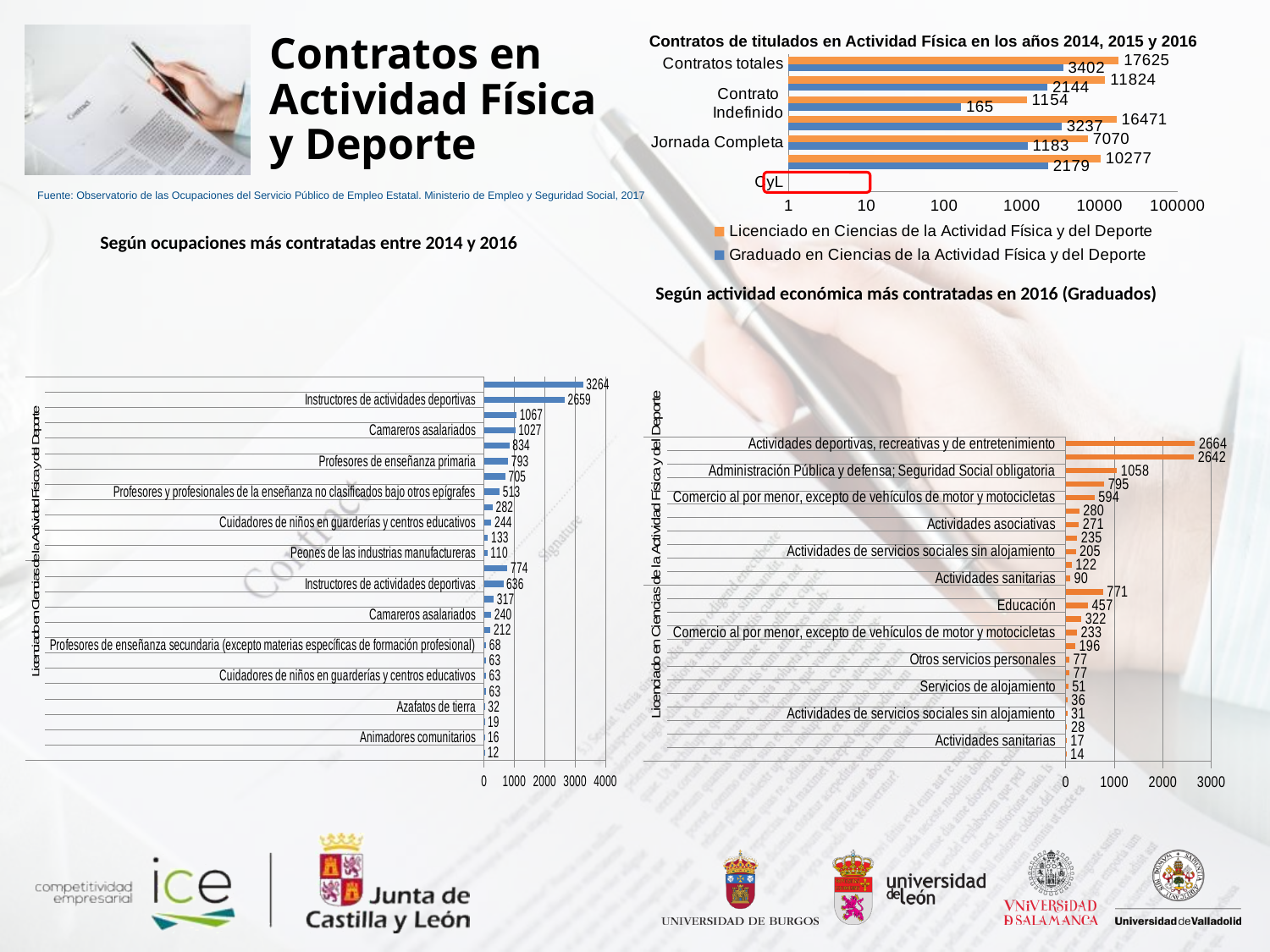
How many series does the legend of the top-right chart 'Contratos de titulados en Actividad Física' list? 2 What is the largest tick value on the x axis of the bottom-left chart 'Según ocupaciones más contratadas entre 2014 y 2016'? 4000 What is the first legend entry of the top-right chart 'Contratos de titulados en Actividad Física'? Licenciado en Ciencias de la Actividad Física y del Deporte What is the largest tick value shown on the x axis of the top-right chart 'Contratos de titulados en Actividad Física'? 100000 What kind of chart is the bottom-right chart 'Según actividad económica más contratadas en 2016 (Graduados)'? bar chart What is the highest labeled value in the bottom-left chart 'Según ocupaciones más contratadas entre 2014 y 2016'? 3264 What is the highest labeled value in the bottom-right chart 'Según actividad económica más contratadas en 2016 (Graduados)'? 2664 In the top-right chart 'Contratos de titulados en Actividad Física', which category contains the bar labeled 165? Contrato Indefinido What kind of chart is the bottom-left chart 'Según ocupaciones más contratadas entre 2014 y 2016'? bar chart In the top-right chart 'Contratos de titulados en Actividad Física', which category contains the bar labeled 17625? Contratos totales What kind of chart is the top-right chart titled 'Contratos de titulados en Actividad Física en los años 2014, 2015 y 2016'? bar chart What is the lowest labeled value in the bottom-right chart 'Según actividad económica más contratadas en 2016 (Graduados)'? 14